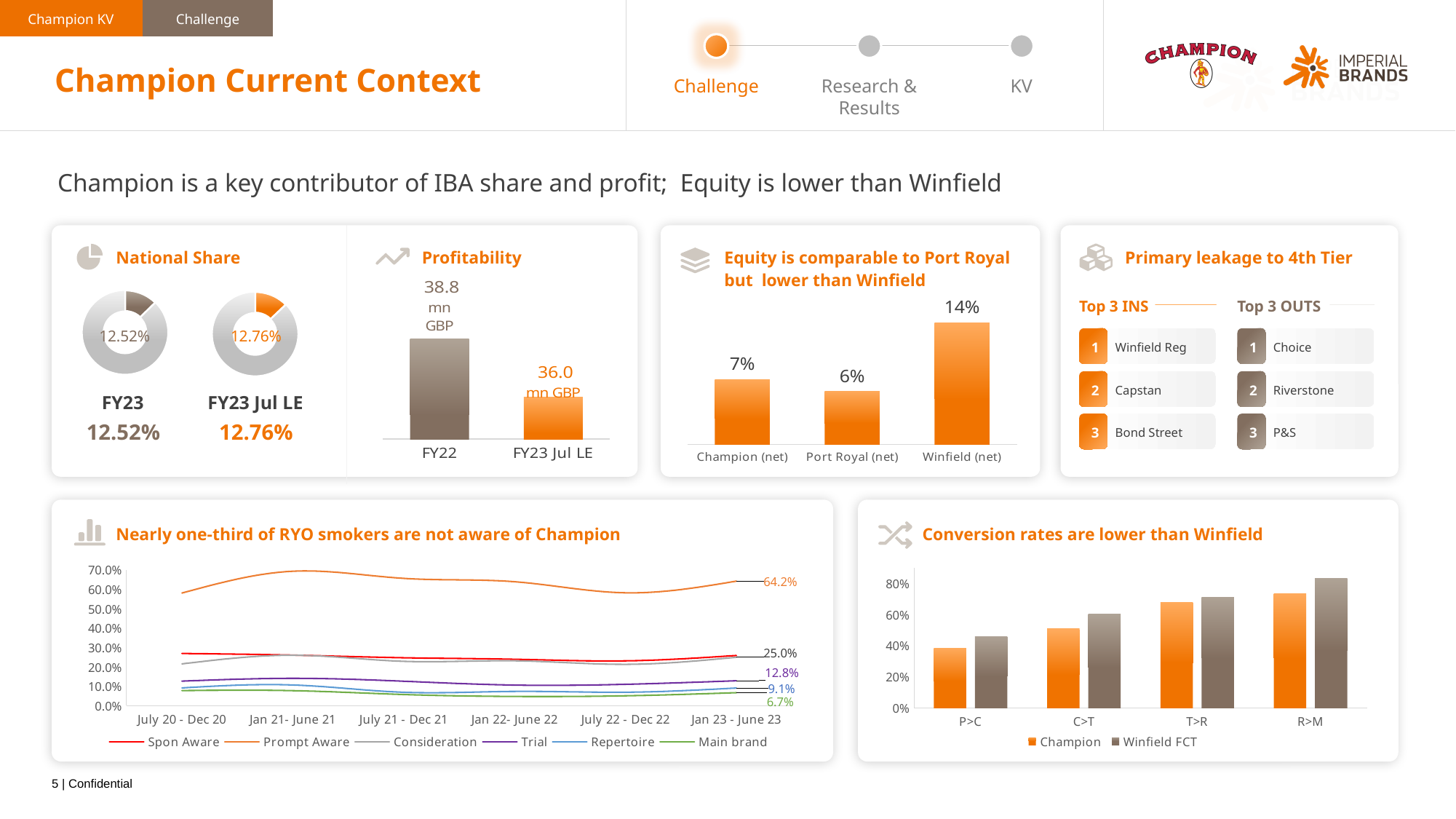
What kind of chart is the 'Nearly one-third of RYO smokers are not aware of Champion' chart? line chart In the 'Equity is comparable to Port Royal but lower than Winfield' chart, what is the difference between Winfield (net) and Champion (net)? 7% In the 'Nearly one-third of RYO smokers are not aware of Champion' chart, what is the final labelled value for Prompt Aware? 64.2% In the Profitability chart, what is the value for FY22? 38.8 mn GBP In the 'Conversion rates are lower than Winfield' chart, do the Champion values rise or fall from P>C to R>M? rise In the 'Conversion rates are lower than Winfield' chart, how many categories are shown on the x axis? 4 In the Profitability chart, which is larger, FY22 or FY23 Jul LE? FY22 In the 'Equity is comparable to Port Royal but lower than Winfield' chart, what is the value for Winfield (net)? 14% How many series does the legend of the 'Nearly one-third of RYO smokers are not aware of Champion' chart list? 6 In the 'Conversion rates are lower than Winfield' chart, is the Champion value for T>R greater or less than 60%? greater In the 'Equity is comparable to Port Royal but lower than Winfield' chart, which category has the lowest value? Port Royal (net) In the National Share chart, what is the value for FY23 Jul LE? 12.76%